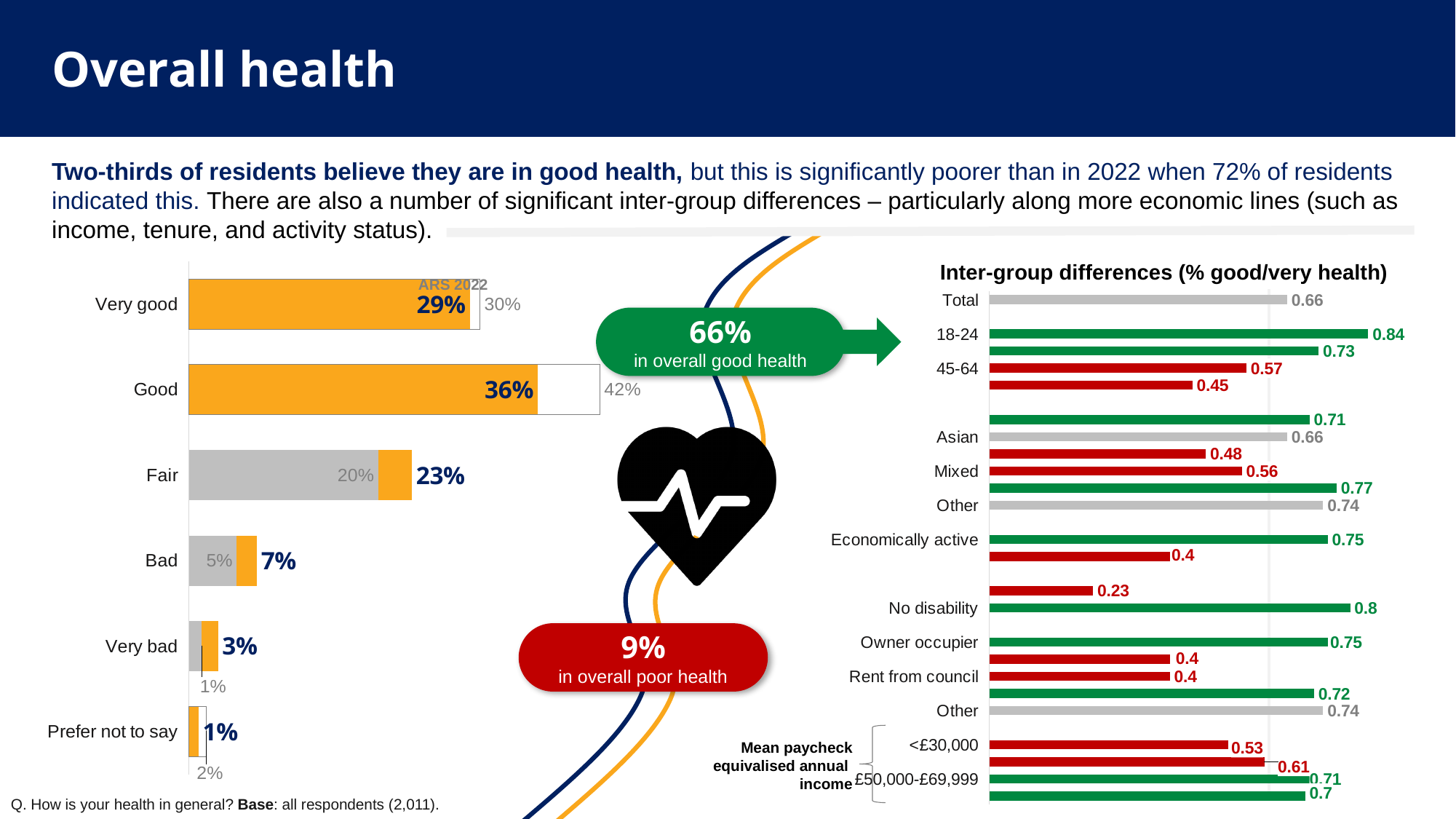
How many health rating categories are shown on the left bar chart? 6 On the 'Inter-group differences' chart, what is the difference between the values for 'Total' and '<£30,000'? 0.13 On the left bar chart, what was the ARS 2022 value for 'Good'? 42% On the 'Inter-group differences' chart, what is the value for 'Rent from council'? 0.4 On the left bar chart, what is the difference between the 'Good' and 'Very good' percentages? 7% On the left bar chart, what percentage of residents rate their health as 'Good'? 36% What type of chart is the 'Inter-group differences (% good/very health)' chart? Bar chart On the left bar chart, which health rating category has the lowest percentage? Prefer not to say On the 'Inter-group differences' chart, what is the value for 18-24? 0.84 On the left bar chart, which health rating category has the highest percentage? Good On the 'Inter-group differences' chart, which is larger: the value for 'No disability' or the value for 'Owner occupier'? No disability On the left bar chart, what percentage of residents rate their health as 'Fair'? 23%